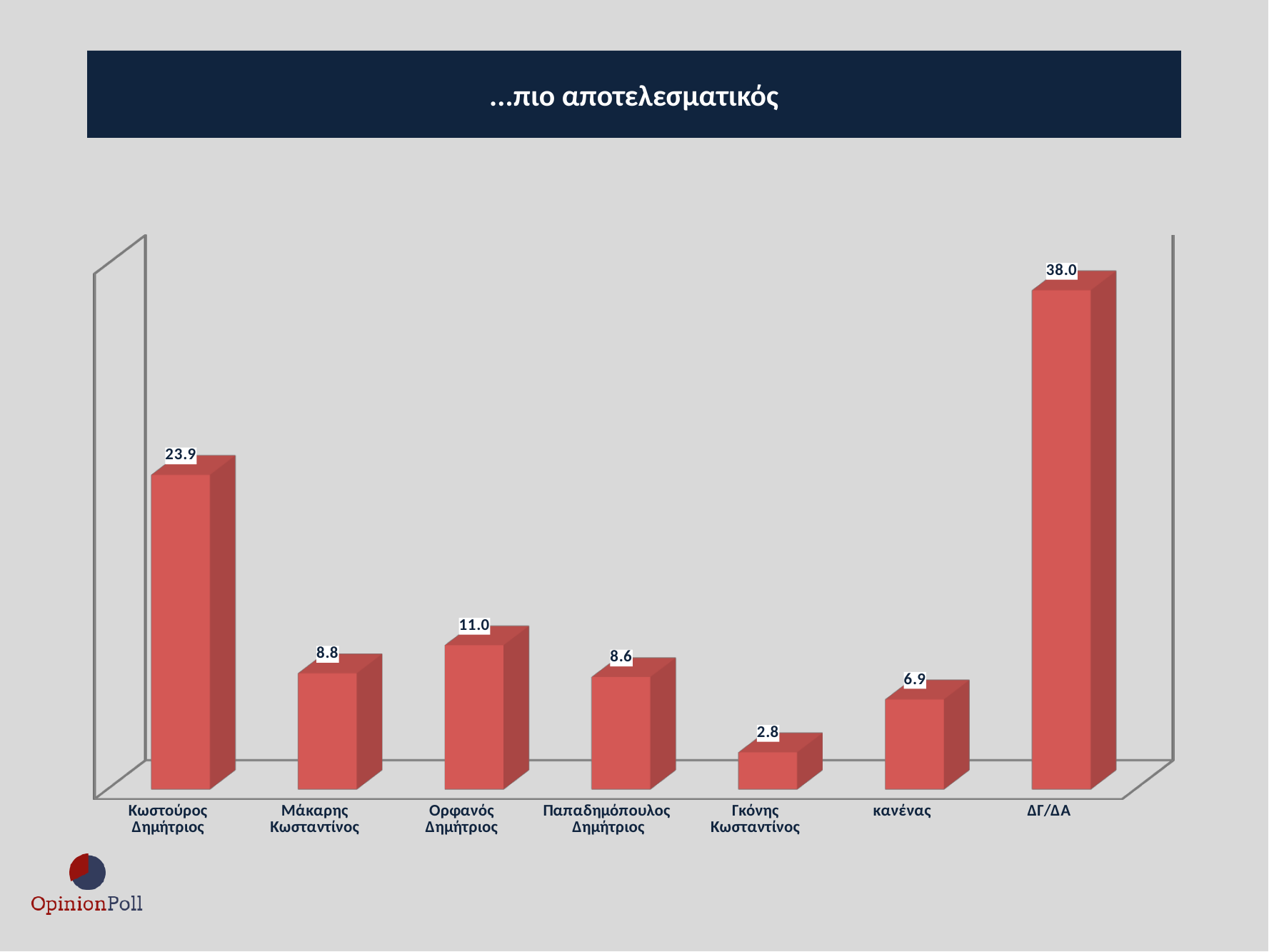
What kind of chart is shown on the slide? bar chart Which category has the highest value? ΔΓ/ΔΑ How many categories are shown on the chart? 7 Which category has the lowest value? Γκόνης Κωσταντίνος Which is larger, the value for Μάκαρης Κωσταντίνος or the value for Ορφανός Δημήτριος? Ορφανός Δημήτριος What is the value for κανένας? 6.9 What is the difference between the values for Ορφανός Δημήτριος and Παπαδημόπουλος Δημήτριος? 2.4 What is the value for Γκόνης Κωσταντίνος? 2.8 What is the title of the chart? ...πιο αποτελεσματικός What is the value for ΔΓ/ΔΑ? 38.0 What is the difference between the values for ΔΓ/ΔΑ and Κωστούρος Δημήτριος? 14.1 What is the value for Κωστούρος Δημήτριος? 23.9